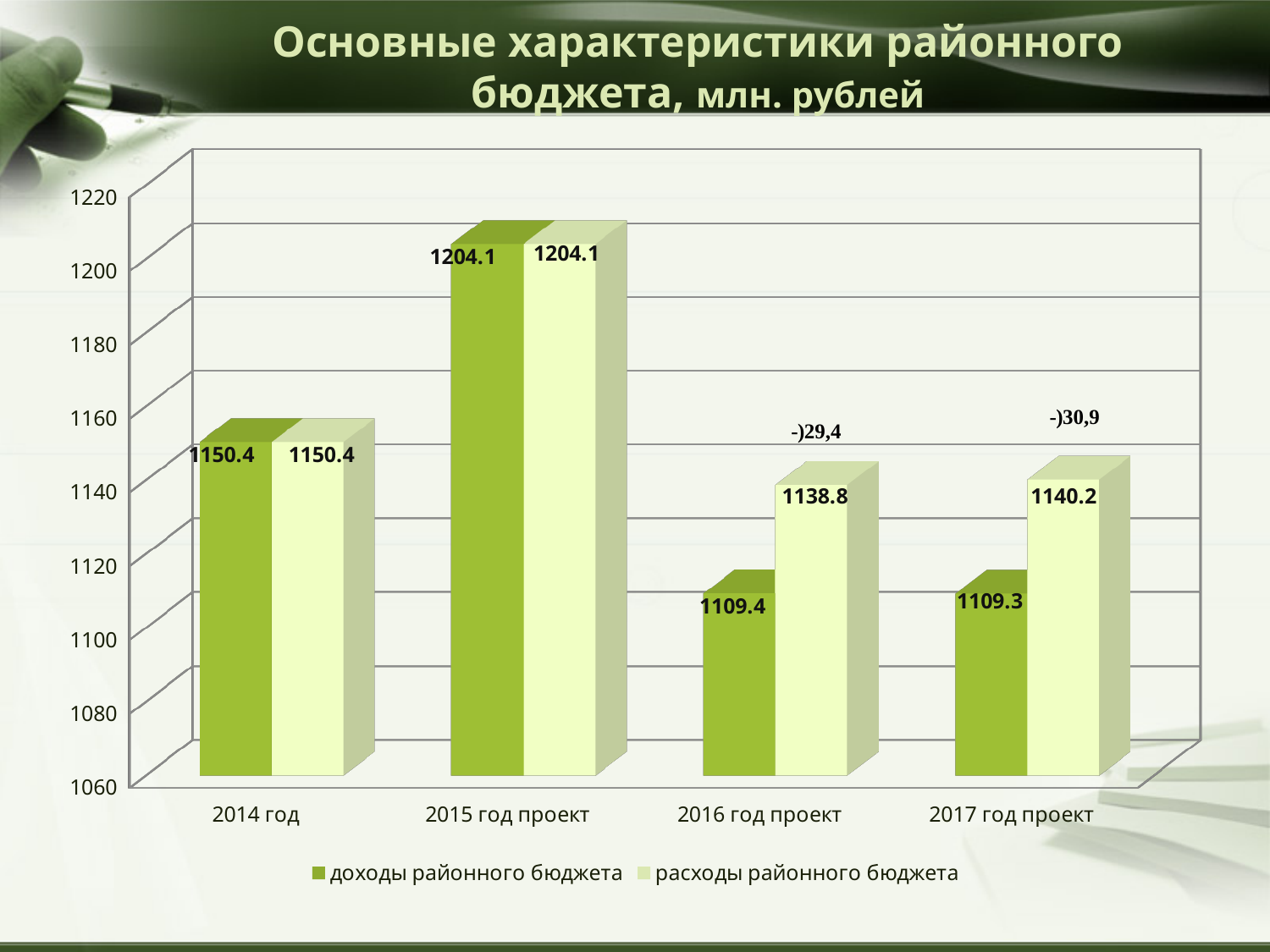
Which is larger for 2016 год проект: доходы районного бюджета or расходы районного бюджета? расходы районного бюджета Which category has the highest value for доходы районного бюджета? 2015 год проект How many categories are shown on the x axis? 4 What is the value of доходы районного бюджета for 2015 год проект? 1204.1 What is the value of расходы районного бюджета for 2016 год проект? 1138.8 Which category has the lowest value for расходы районного бюджета? 2016 год проект What is the title of the chart on the slide? Основные характеристики районного бюджета, млн. рублей What kind of chart is shown on the slide? bar chart What is the value of доходы районного бюджета for 2017 год проект? 1109.3 How many series does the legend list? 2 What is the difference between расходы районного бюджета and доходы районного бюджета for 2017 год проект? 30.9 What is the value of расходы районного бюджета for 2014 год? 1150.4